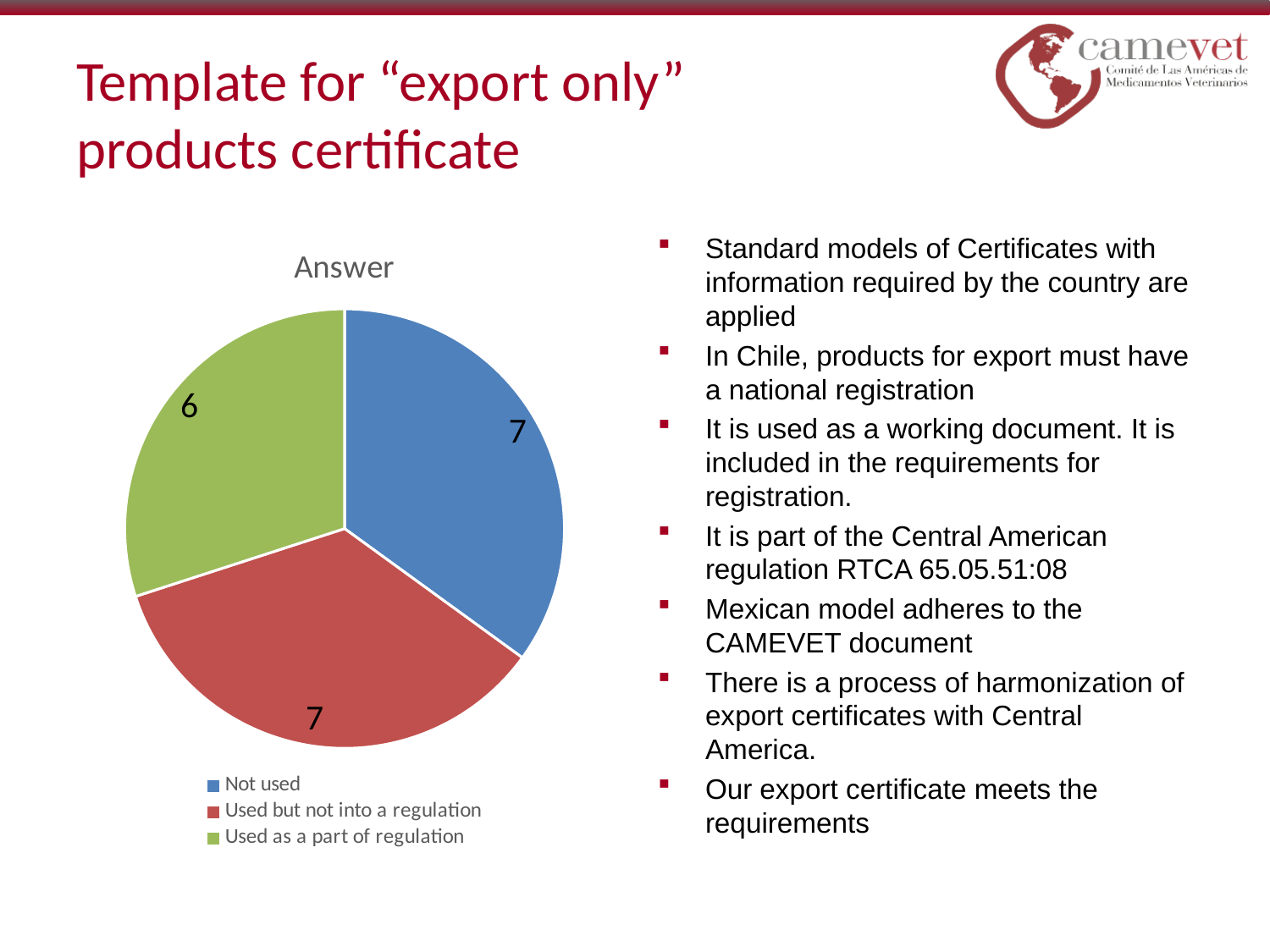
What is the value for "Used as a part of regulation"? 6 How many entries does the chart legend list? 3 What share of the pie does "Used as a part of regulation" represent? 30% Which category has the smallest slice? Used as a part of regulation What is the value for "Used but not into a regulation"? 7 What kind of chart is shown on the slide? pie chart How many slices does the pie chart have? 3 What is the difference between the values for "Not used" and "Used as a part of regulation"? 1 What is the total of all slices in the pie chart? 20 What is the value for "Not used"? 7 What is the title of the chart? Answer Which is larger, the value for "Used but not into a regulation" or the value for "Used as a part of regulation"? Used but not into a regulation